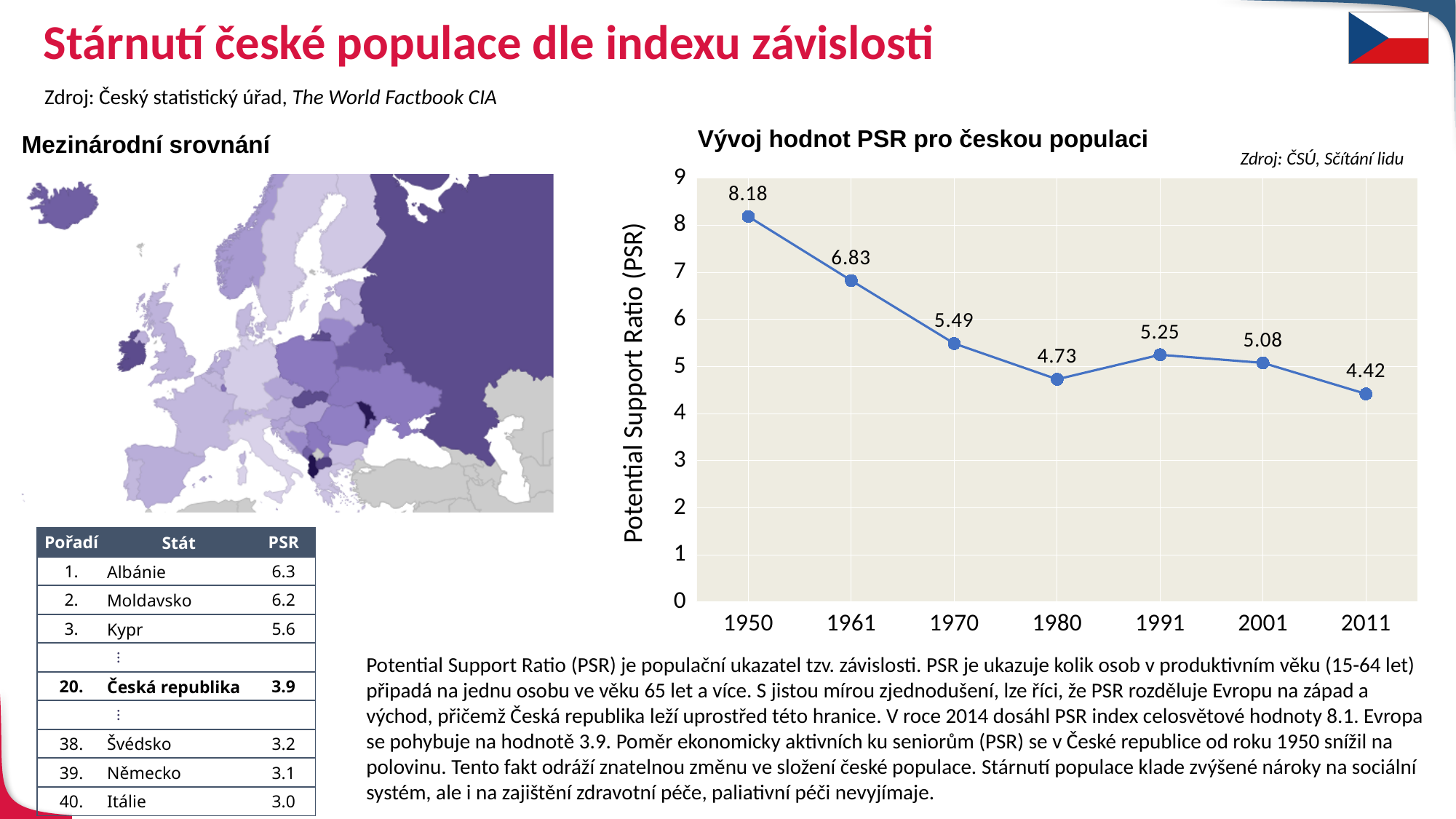
In the chart "Vývoj hodnot PSR pro českou populaci", does the PSR value generally rise or fall from 1950 to 2011? fall In the chart "Vývoj hodnot PSR pro českou populaci", which year has the lowest PSR value? 2011 In the chart "Vývoj hodnot PSR pro českou populaci", which year has the highest PSR value? 1950 What type of chart is "Vývoj hodnot PSR pro českou populaci"? line chart In the chart "Vývoj hodnot PSR pro českou populaci", is the PSR value for 1961 greater or less than 7? less In the chart "Vývoj hodnot PSR pro českou populaci", what is the PSR value for 1980? 4.73 In the chart "Vývoj hodnot PSR pro českou populaci", what is the difference between the PSR values for 1950 and 2011? 3.76 In the chart "Vývoj hodnot PSR pro českou populaci", what is the PSR value for 2011? 4.42 In the chart "Vývoj hodnot PSR pro českou populaci", what is the PSR value for 1950? 8.18 How many data points are plotted in the chart "Vývoj hodnot PSR pro českou populaci"? 7 What is the label of the vertical axis in the chart "Vývoj hodnot PSR pro českou populaci"? Potential Support Ratio (PSR) In the chart "Vývoj hodnot PSR pro českou populaci", which year has a higher PSR value, 1991 or 2001? 1991